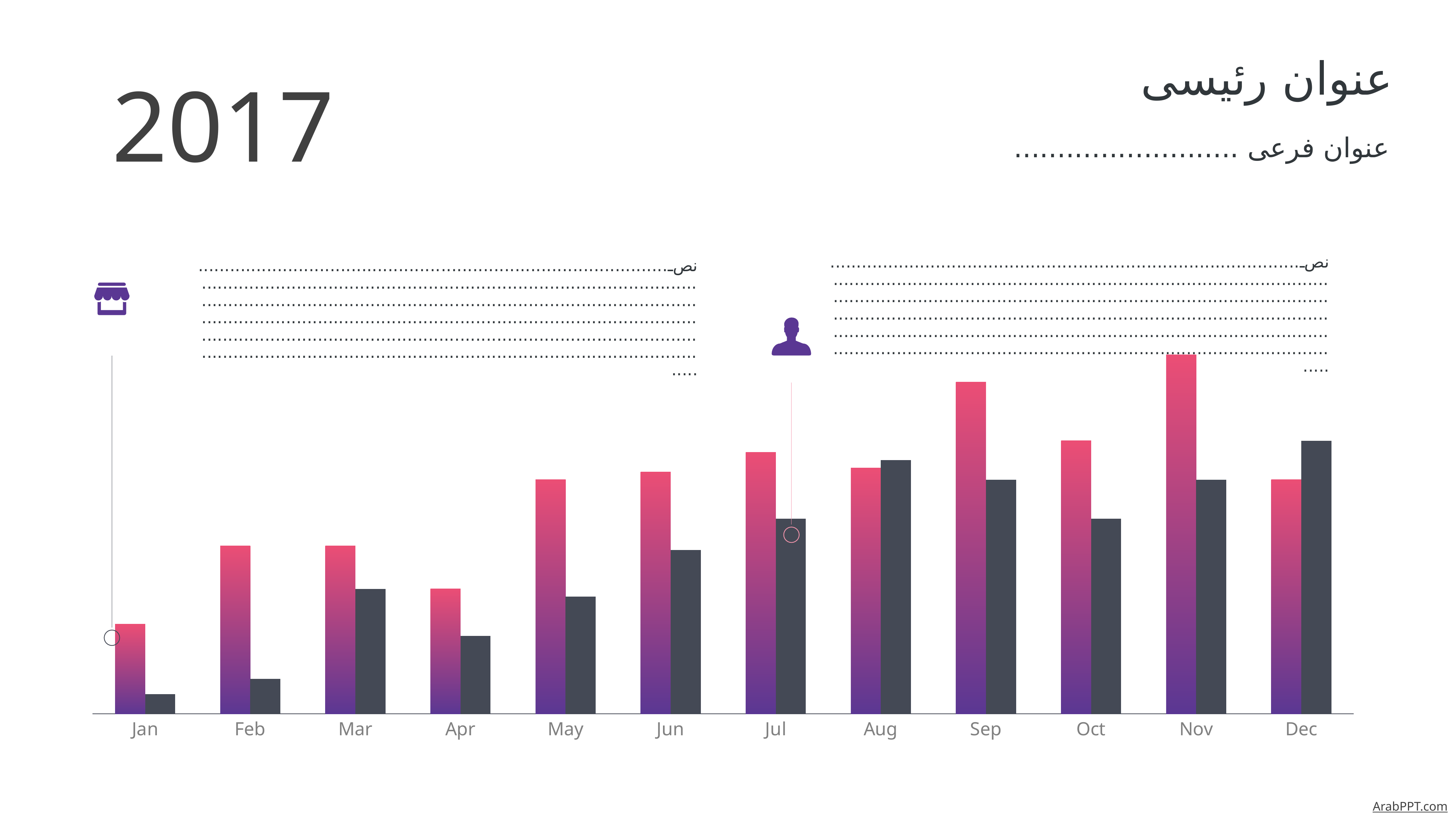
Which month has the tallest dark gray bar? Dec What year is shown as the large heading above the chart? 2017 Which month has the shortest dark gray bar? Jan How many months are shown along the x axis of the chart? 12 Which month has the shortest pink bar? Jan How many bars are plotted for each month in the chart? 2 In Jan, which bar is taller, the pink bar or the dark gray bar? the pink bar Do the dark gray bars generally rise or fall from Jan to Dec? rise In Dec, which bar is taller, the pink bar or the dark gray bar? the dark gray bar Which month has the tallest pink bar? Nov Which month has a taller pink bar, Sep or Oct? Sep What kind of chart is shown on the slide? bar chart